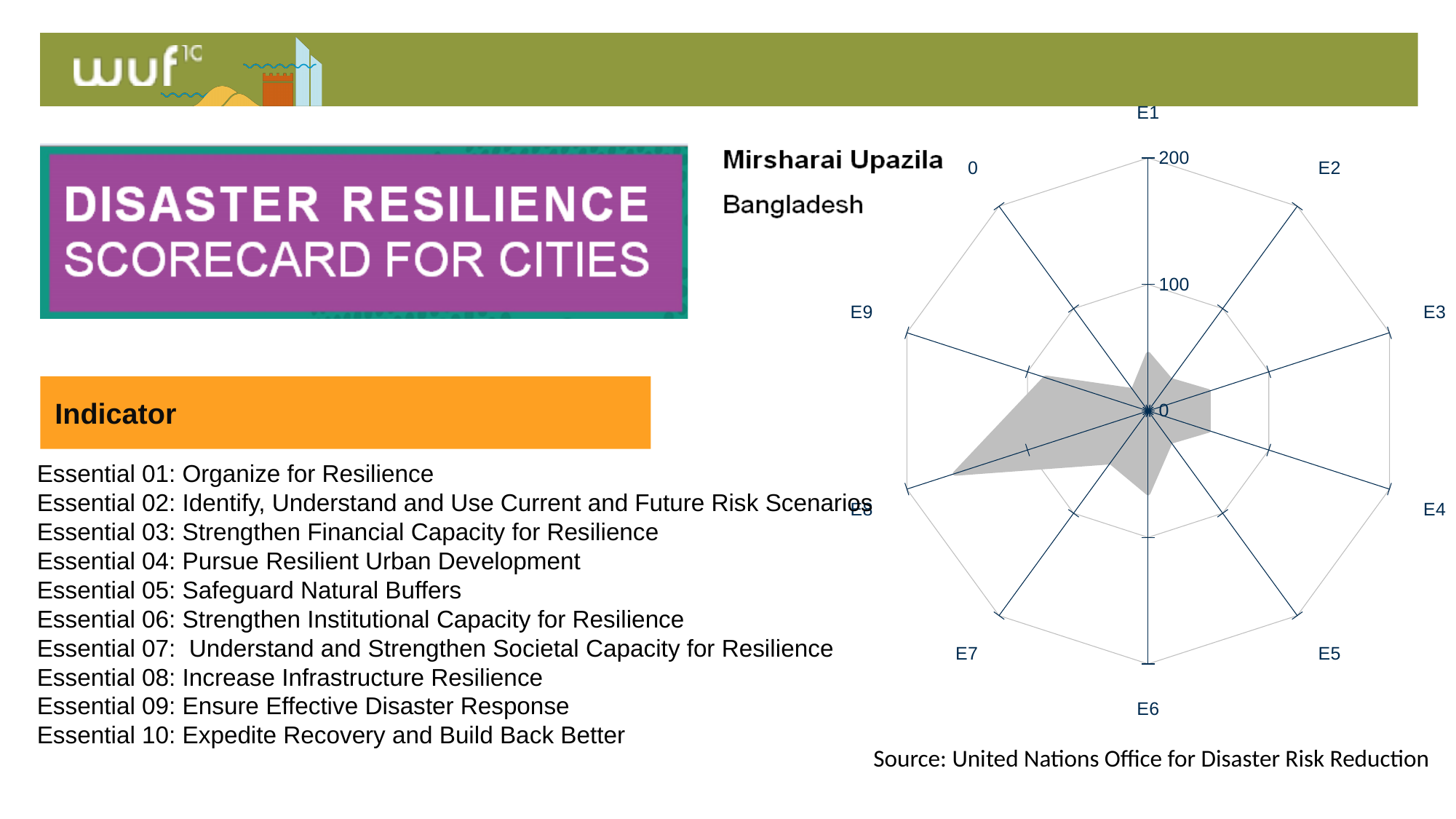
Which has the larger value on the radar chart, E8 or E1? E8 Is the value for E3 on the radar chart greater or less than 100? less What is the maximum value shown on the radar chart's scale? 200 Which city and country does the radar chart refer to? Mirsharai Upazila, Bangladesh Is the value for E5 on the radar chart greater or less than 100? less Which axis of the radar chart has the highest value? E8 Which has the larger value on the radar chart, E8 or E5? E8 How many axes (spokes) does the radar chart have? 10 What kind of chart is shown on the right of the slide? Radar chart Is the value for E6 on the radar chart greater or less than 100? less